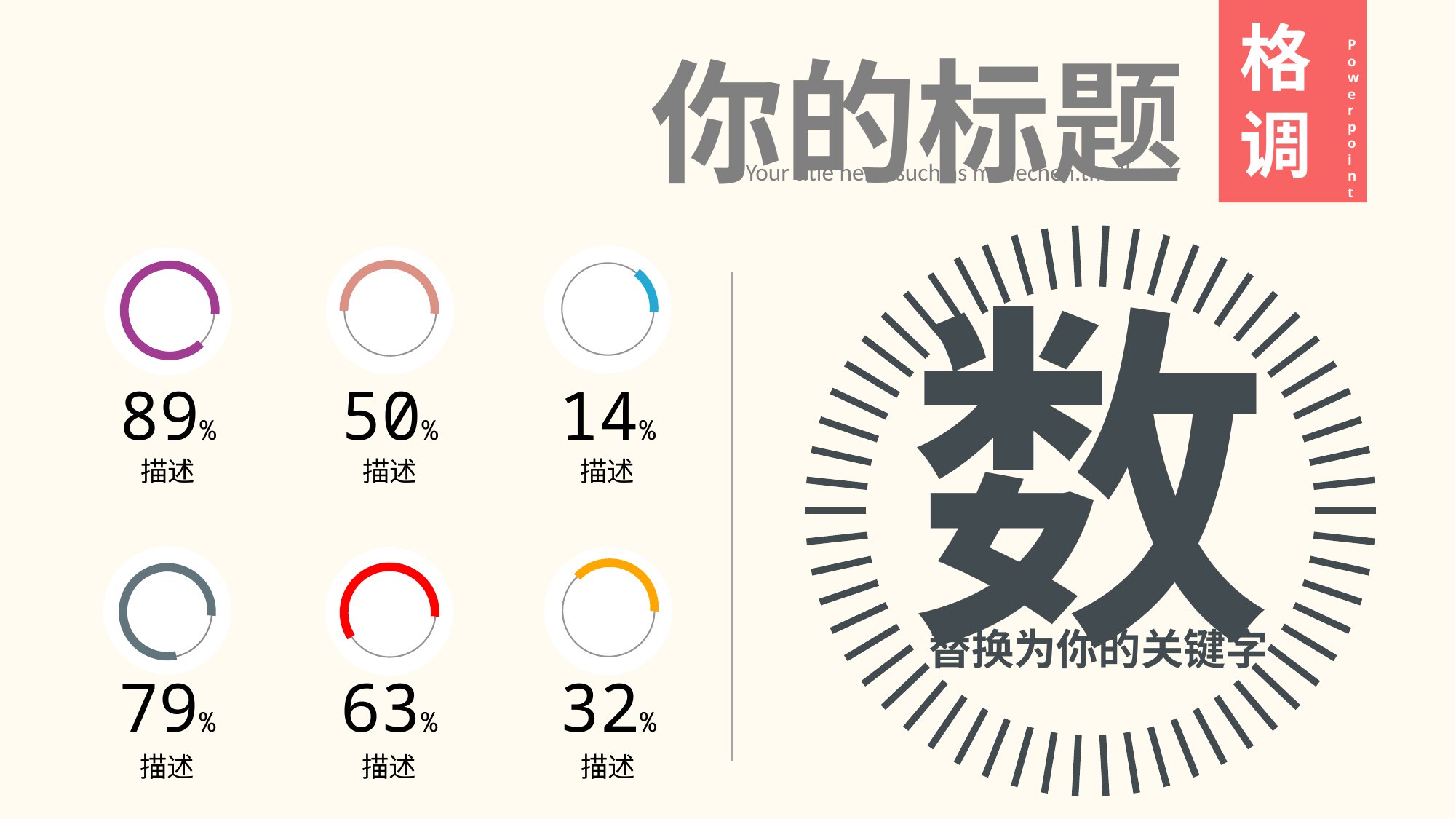
What colour is the filled arc of the bottom-middle ring chart? Red Which is larger, the value of the bottom-middle ring chart or the top-middle ring chart? Bottom-middle (63%) What value is shown for the top-left ring chart? 89% What is the difference between the top-left ring chart value and the bottom-left ring chart value? 10% Which of the six ring charts shows the highest value? Top-left (89%) Which of the six ring charts shows the lowest value? Top-right (14%) What value is shown for the bottom-left ring chart? 79% What value is shown for the bottom-middle ring chart? 63% How many ring charts are shown on the slide? 6 What value is shown for the top-middle ring chart? 50% What value is shown for the top-right ring chart? 14% What value is shown for the bottom-right ring chart? 32%